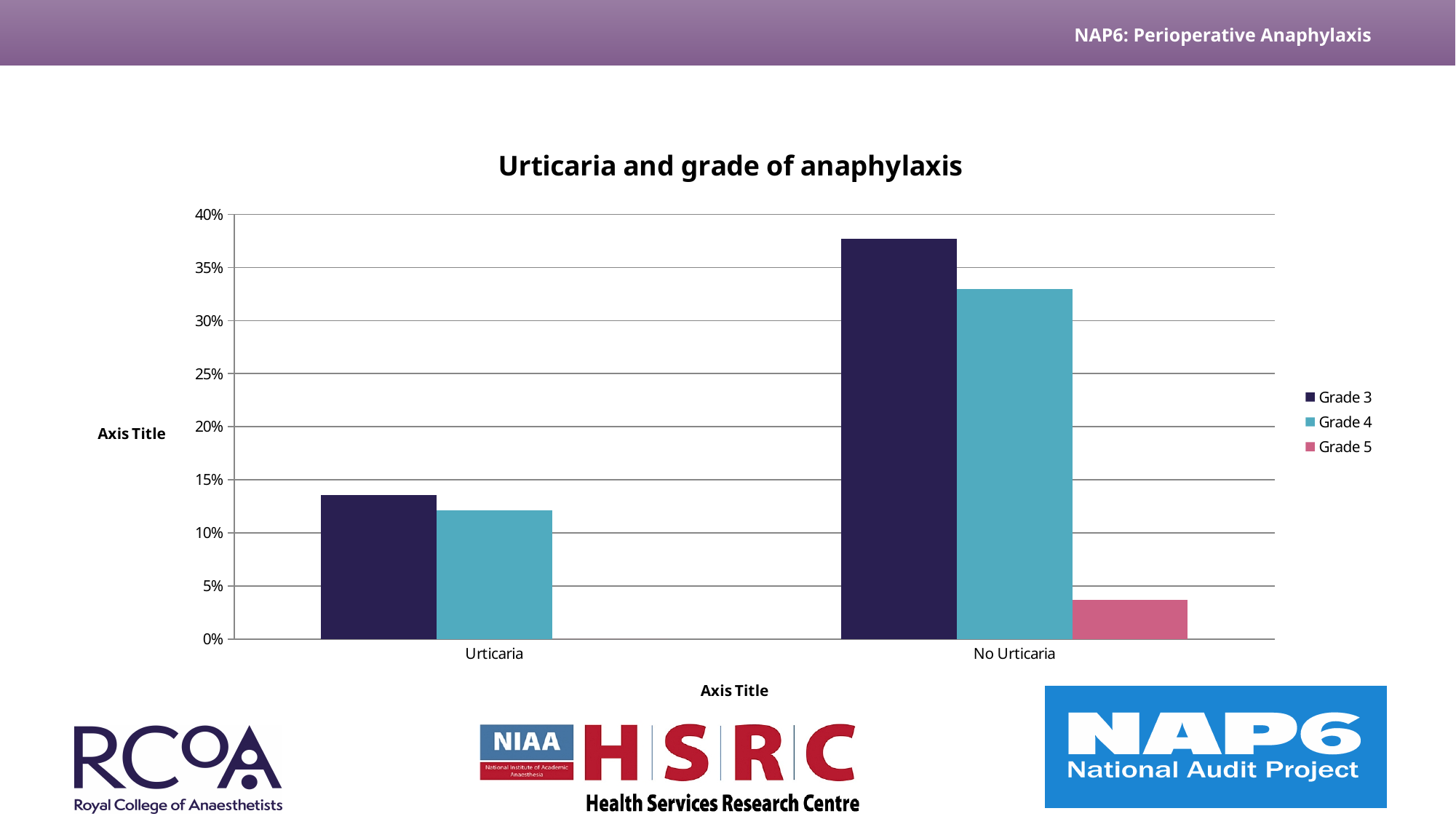
Is the Grade 3 value for Urticaria greater or less than 15%? less What kind of chart is shown on the slide? bar chart Is the Grade 4 value for No Urticaria greater or less than 30%? greater Is the Grade 3 value for No Urticaria greater or less than 35%? greater Which series is shown in pink in the legend? Grade 5 How many categories are shown on the x axis? 2 Which series has the tallest bar in the chart? Grade 3 How many series does the legend list? 3 What is the title of the chart? Urticaria and grade of anaphylaxis For No Urticaria, which is larger: the Grade 3 value or the Grade 4 value? Grade 3